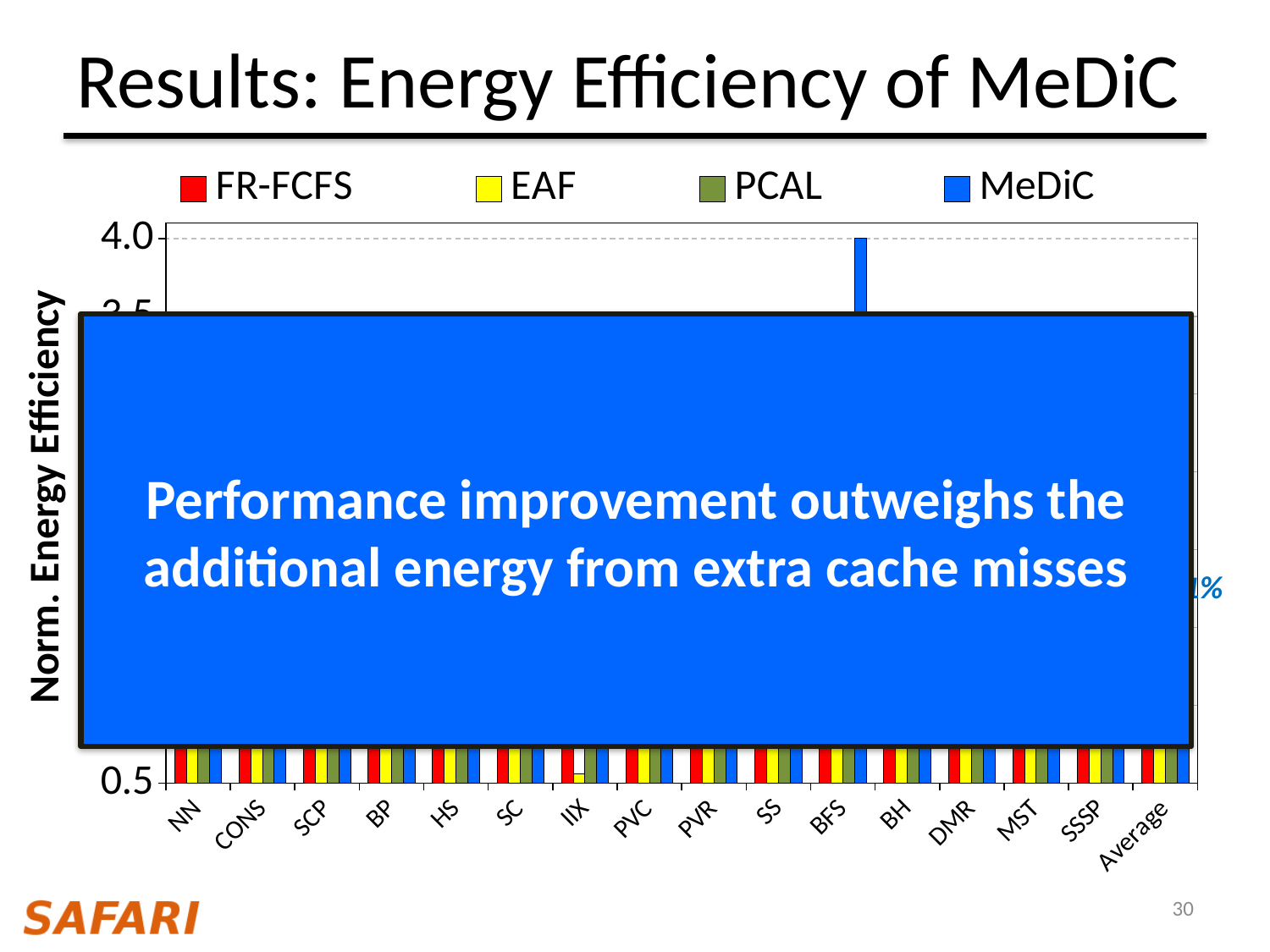
What kind of chart is shown on the slide? bar chart Which series is shown in blue in the legend? MeDiC How many series does the legend list? 4 Which category has the highest MeDiC value? BFS Is the MeDiC value for BFS greater or less than 3.5? greater How many categories are shown along the x axis? 16 Is the MeDiC value for BFS greater or less than 3.0? greater What is the last category on the x axis? Average What is the label of the y axis? Norm. Energy Efficiency What is the first category on the x axis? NN